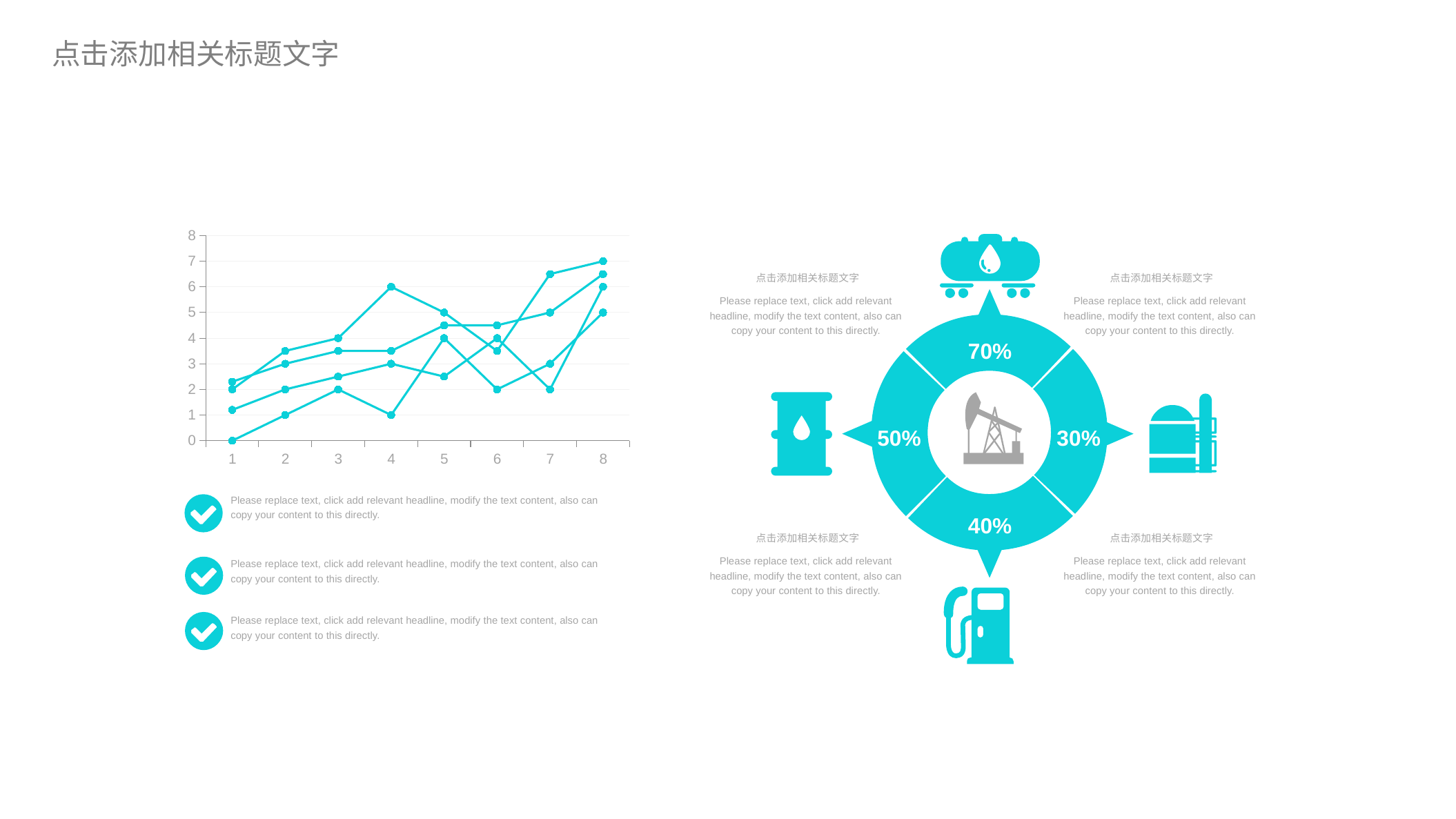
Do the lines in the line chart generally rise or fall from x = 1 to x = 8? rise How many points are there along the x axis of the line chart? 8 How many lines are plotted in the line chart on the left? 4 In the ring diagram on the right, what percentage is shown in the top segment? 70% In the line chart, is the lowest value at x = 8 greater or less than 4? greater In the line chart, is the highest value at x = 8 greater or less than 6? greater What kind of chart is shown on the left of the slide? line chart What is the highest value shown on the y axis of the line chart? 8 What is the highest value reached by any line in the line chart? 7 At which x-axis point does the lowest value of 0 occur in the line chart? 1 What is the lowest value plotted in the line chart? 0 At which x-axis point does a line reach its highest value of 7 in the line chart? 8